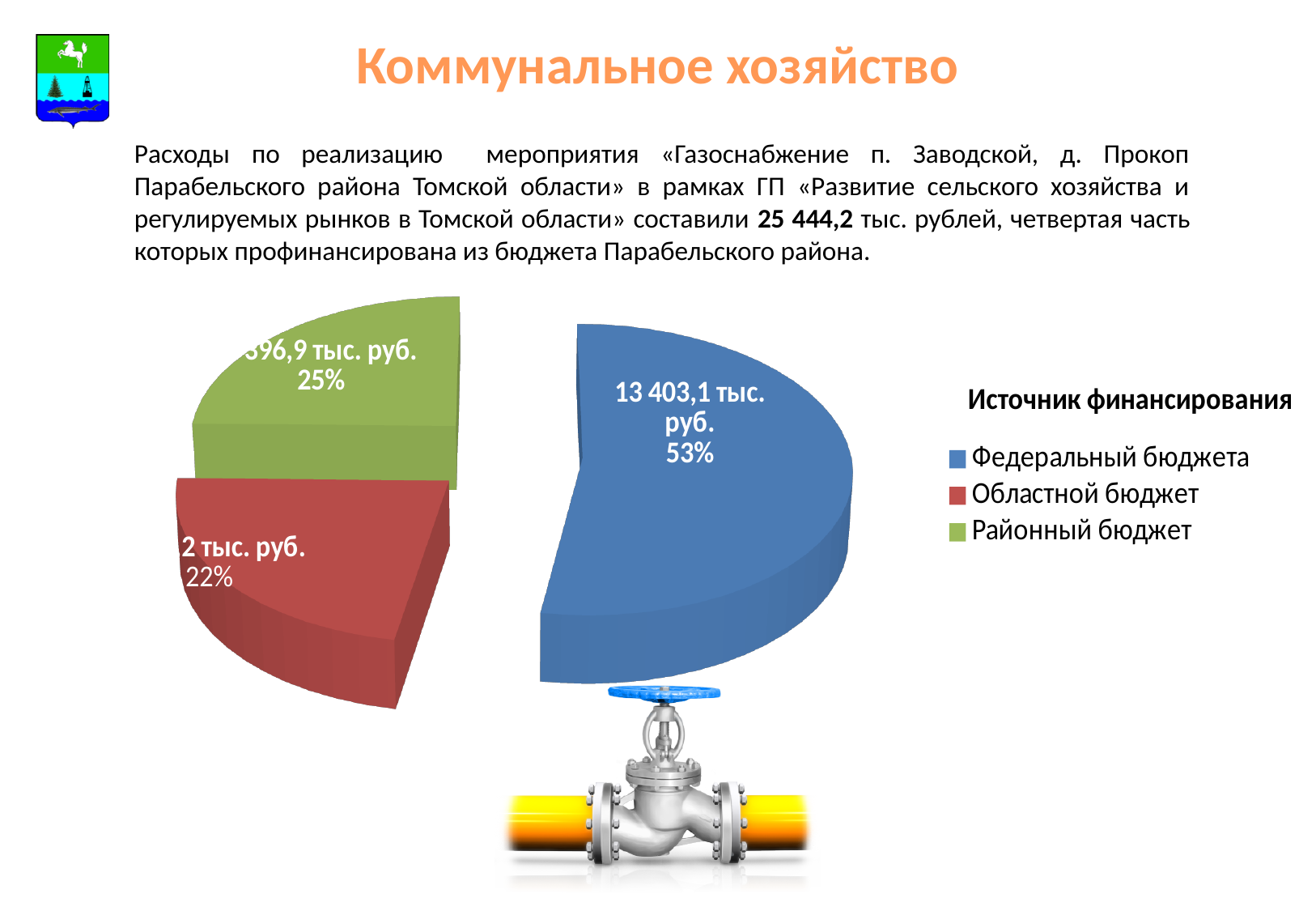
Which funding source has the largest slice in the pie chart? Федеральный бюджета How many funding sources does the legend of the pie chart list? 3 What is the title of the legend next to the pie chart? Источник финансирования What is the value shown for Федеральный бюджета in the pie chart? 13 403,1 тыс. руб. How many slices does the pie chart have? 3 Which slice is larger: Районный бюджет or Областной бюджет? Районный бюджет Which funding source has the smallest slice in the pie chart? Областной бюджет What share of the pie does Областной бюджет account for? 22% What share of the pie does Районный бюджет account for? 25% What kind of chart is shown on the slide? pie chart By how many percentage points does the share of Федеральный бюджета exceed the share of Районный бюджет? 28% What share of the pie does Федеральный бюджета account for? 53%